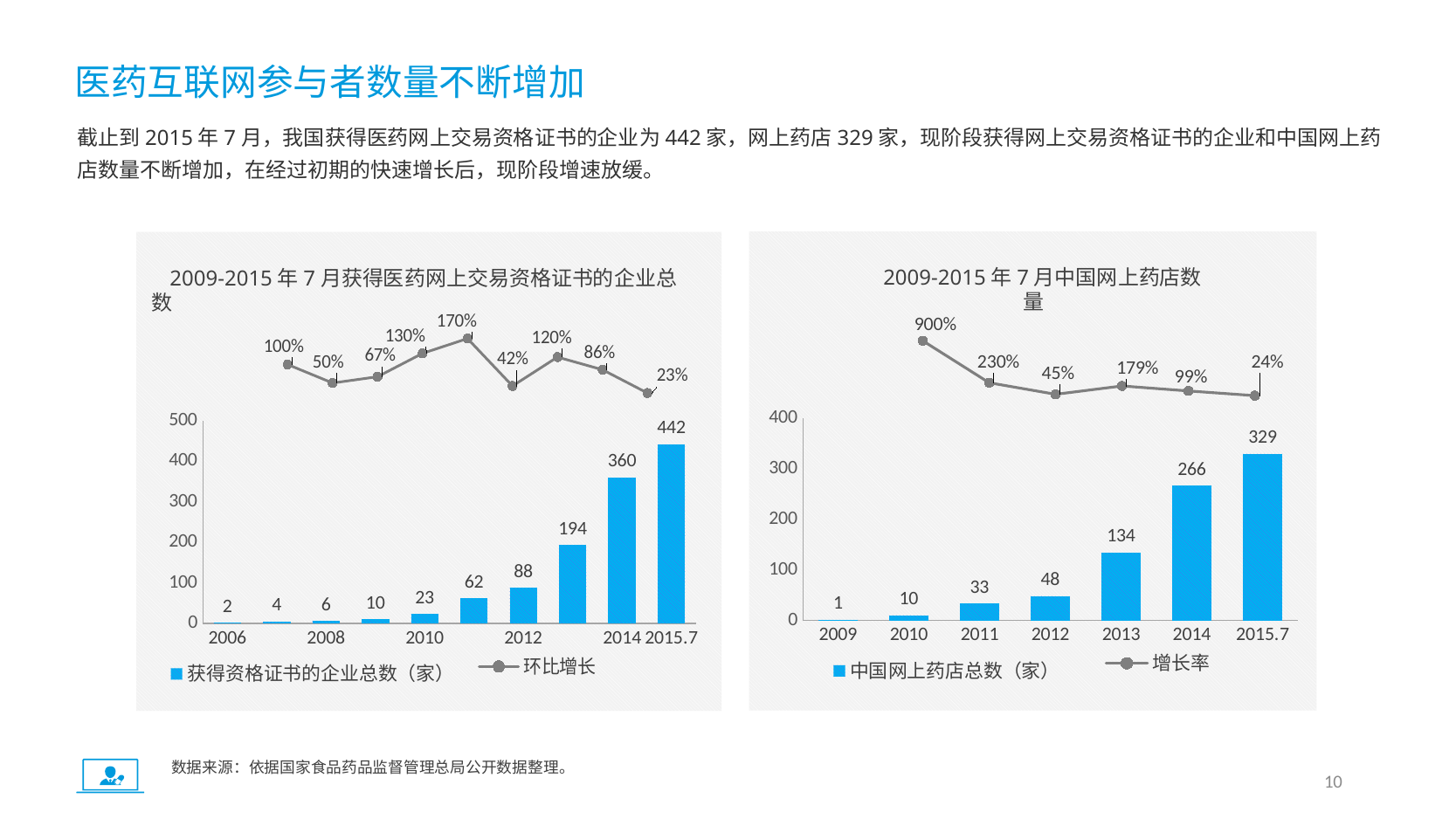
In the left chart, how many bars are plotted? 10 In the right chart, do the bar values rise or fall from 2009 to 2015.7? rise In the right chart, what is the number of Chinese online pharmacies in 2013? 134 In the right chart, what is the difference between the 2015.7 and 2014 bar values? 63 In the right chart, what is the 增长率 value for 2010? 900% In the left chart, what is the value of the bar for 2012? 88 In the left chart, what is the difference between the 2015.7 and 2014 bar values? 82 In the right chart, which year has the lowest number of online pharmacies? 2009 In the right chart, how many series does the legend list? 2 In the left chart, what is the 环比增长 value shown for the last point (2015.7)? 23% In the left chart, what is the total number of enterprises with certificates in 2015.7? 442 In the left chart, what is the value of the bar for 2014? 360